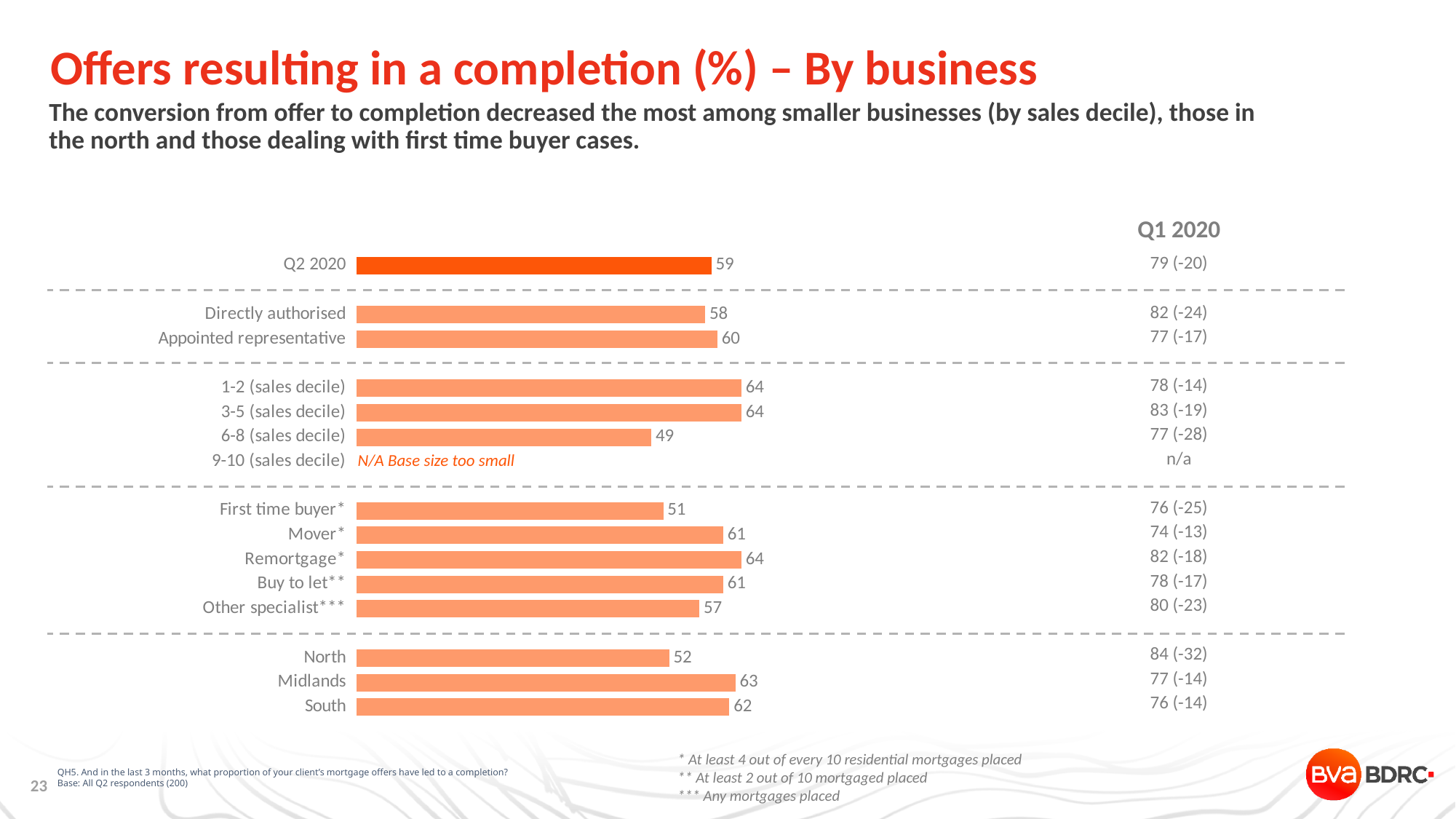
What is the Q2 2020 value for Directly authorised? 58 How many bars are plotted on the chart? 14 What is the value shown for 6-8 (sales decile)? 49 What type of chart is shown on the slide? bar chart Which has the larger value, Directly authorised or Appointed representative? Appointed representative What is the difference between the values for Midlands and North? 11 What is written next to 9-10 (sales decile) instead of a bar? N/A Base size too small Which category has the lowest plotted value? 6-8 (sales decile) Which has the larger value, South or North? South What is the value shown for Midlands? 63 What is the value shown for First time buyer? 51 What is the difference between the values for Remortgage and First time buyer? 13